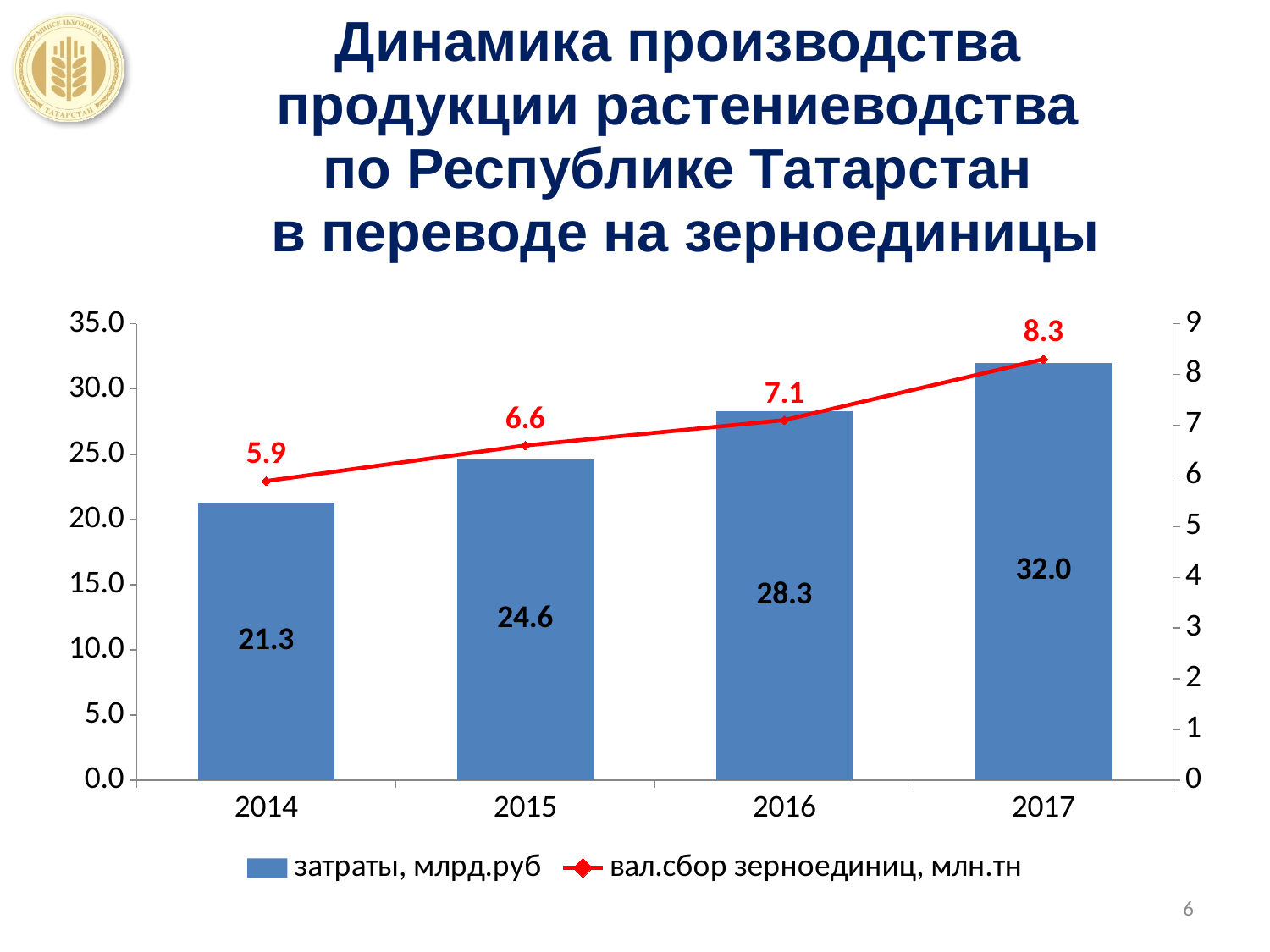
Do the values for вал.сбор зерноединиц, млн.тн rise or fall from 2014 to 2017? rise How many years are shown on the x axis? 4 What is the value of затраты, млрд.руб for 2014? 21.3 Which year has the larger value for затраты, млрд.руб: 2015 or 2016? 2016 Which year has the lowest value for вал.сбор зерноединиц, млн.тн? 2014 What is the value of затраты, млрд.руб for 2016? 28.3 What is the difference between вал.сбор зерноединиц, млн.тн in 2017 and 2016? 1.2 What is the value of вал.сбор зерноединиц, млн.тн for 2015? 6.6 Which year has the highest value for затраты, млрд.руб? 2017 What colour is the line for вал.сбор зерноединиц, млн.тн? red What is the difference between затраты, млрд.руб in 2017 and 2014? 10.7 How many series does the legend list? 2